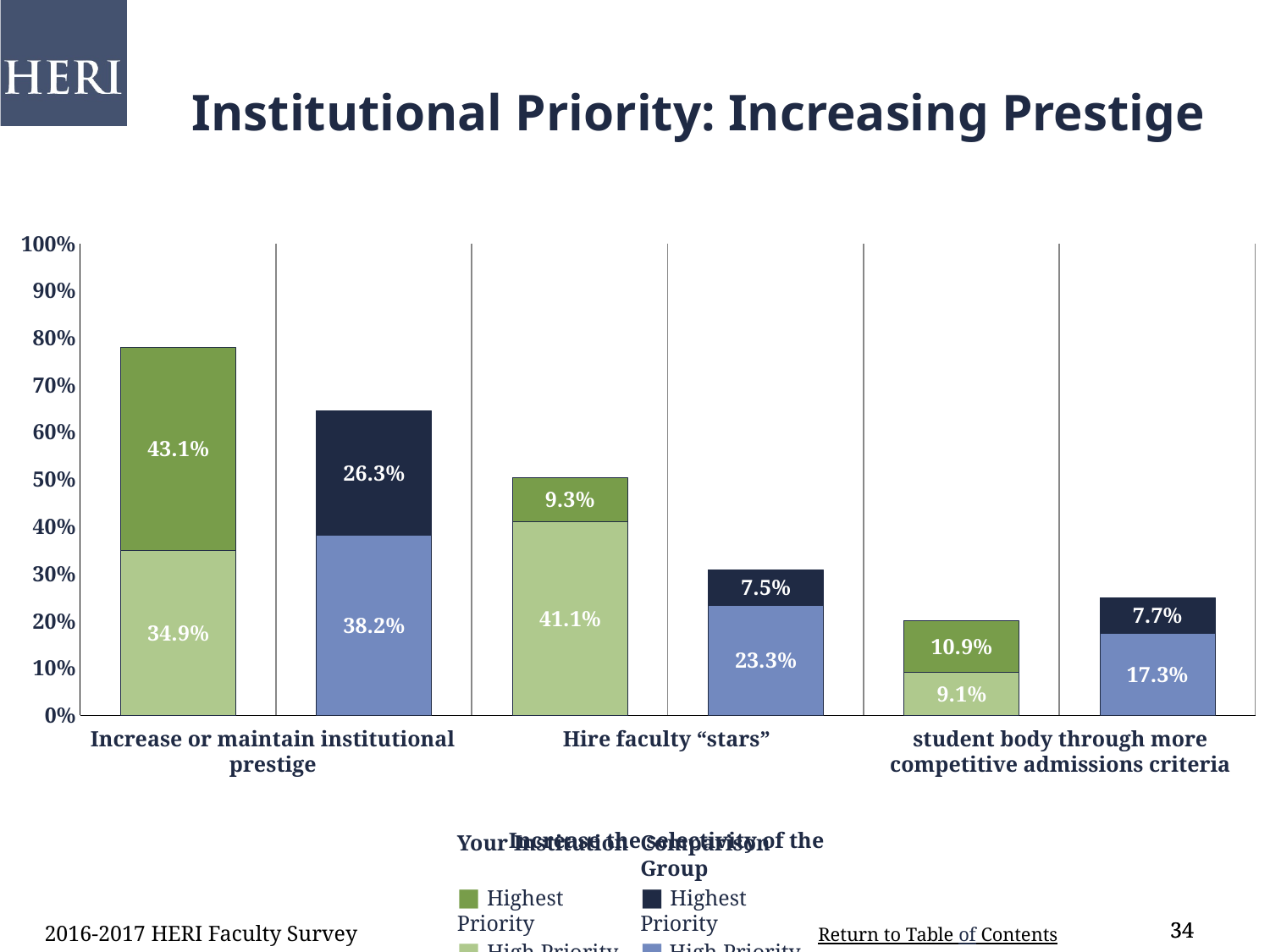
What type of chart is shown on the slide? stacked bar chart Which category has the lowest total for the Your Institution stacked bar? Increase the selectivity of the student body through more competitive admissions criteria What is the High Priority value for the Comparison Group for "Increase or maintain institutional prestige"? 38.2% What is the total height of the Your Institution stacked bar for "Increase or maintain institutional prestige"? 78.0% What is the Highest Priority value for Your Institution for "Increase or maintain institutional prestige"? 43.1% What is the title of the chart on the slide? Institutional Priority: Increasing Prestige How many categories are shown along the x axis of the chart? 3 What is the total height of the Comparison Group stacked bar for "Hire faculty “stars”"? 30.8% What is the High Priority value for Your Institution for "Hire faculty “stars”"? 41.1% For "Hire faculty “stars”", which is larger: the High Priority value for Your Institution or for the Comparison Group? Your Institution What is the difference between the Highest Priority values for Your Institution and the Comparison Group for "Increase or maintain institutional prestige"? 16.8% What is the Highest Priority value for the Comparison Group for "Hire faculty “stars”"? 7.5%